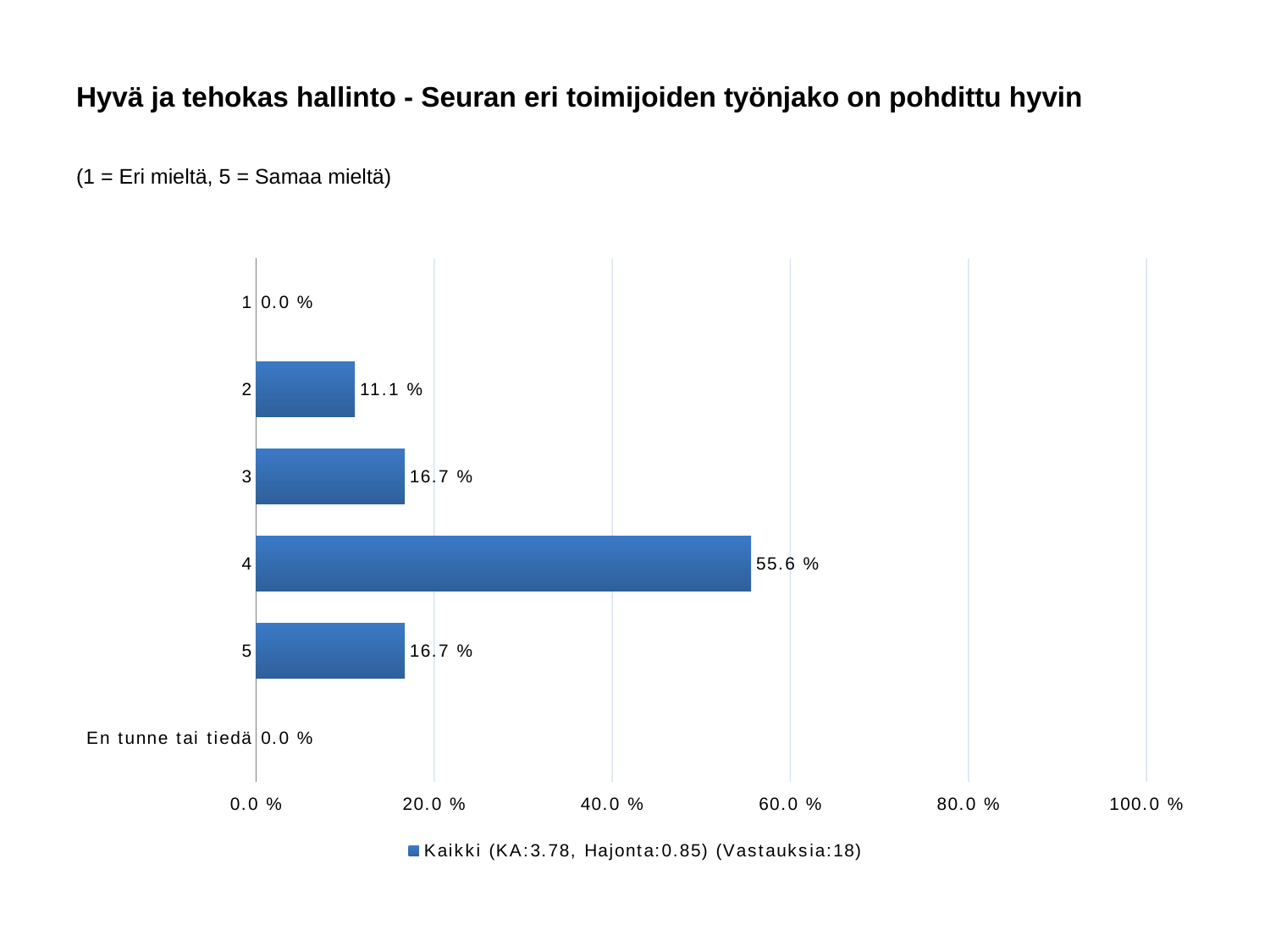
What is the value for category 4? 55.6 % What is the difference between the values for category 3 and category 2? 5.6 % How many categories are shown on the chart? 6 Is the value for category 4 greater or less than 40.0 %? greater Which category has the highest value? 4 What is the value for category 2? 11.1 % How many series does the legend list? 1 What is the difference between the values for category 4 and category 3? 38.9 % What is the value for "En tunne tai tiedä"? 0.0 % What kind of chart is shown on the slide? bar chart Which is larger, the value for category 2 or the value for category 5? 5 What is the legend entry for the series? Kaikki (KA:3.78, Hajonta:0.85) (Vastauksia:18)